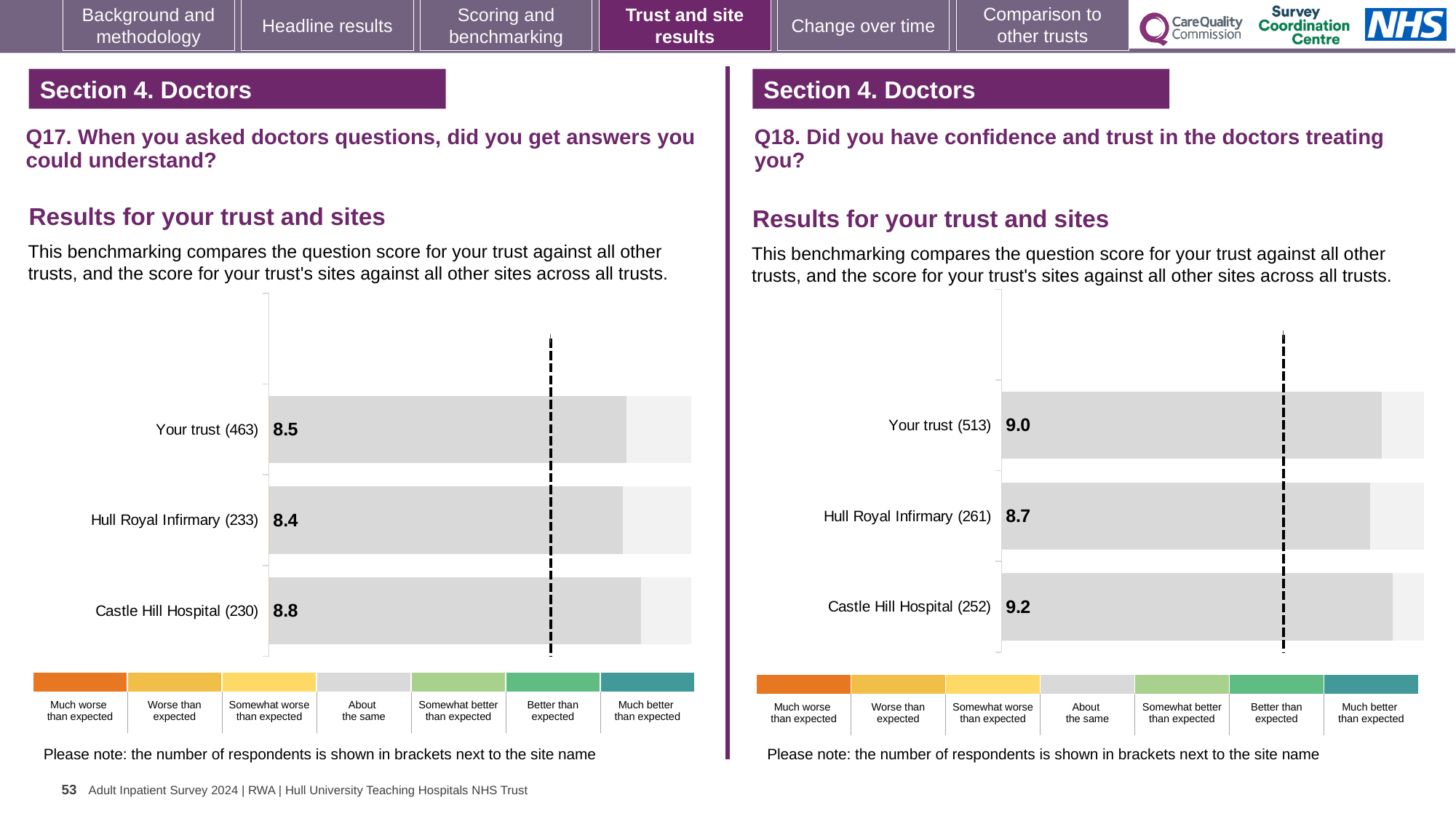
On the Q18 chart (right), which has the higher score, Your trust or Hull Royal Infirmary? Your trust What type of chart is used on the Q18 chart (right)? Bar chart On the Q18 chart (right), what is the score for Hull Royal Infirmary? 8.7 On the Q18 chart (right), which site or trust has the lowest score? Hull Royal Infirmary On the Q17 chart (left), what is the score for Castle Hill Hospital? 8.8 On the Q18 chart (right), how many respondents are shown in brackets for Castle Hill Hospital? 252 On the Q17 chart (left), which site or trust has the highest score? Castle Hill Hospital How many bars are shown on the Q17 chart (left)? 3 On the Q18 chart (right), what is the difference between the scores for Castle Hill Hospital and Your trust? 0.2 On the Q17 chart (left), what is the score for Your trust? 8.5 On the Q17 chart (left), what is the difference between the scores for Castle Hill Hospital and Hull Royal Infirmary? 0.4 On the Q18 chart (right), what is the score for Your trust? 9.0